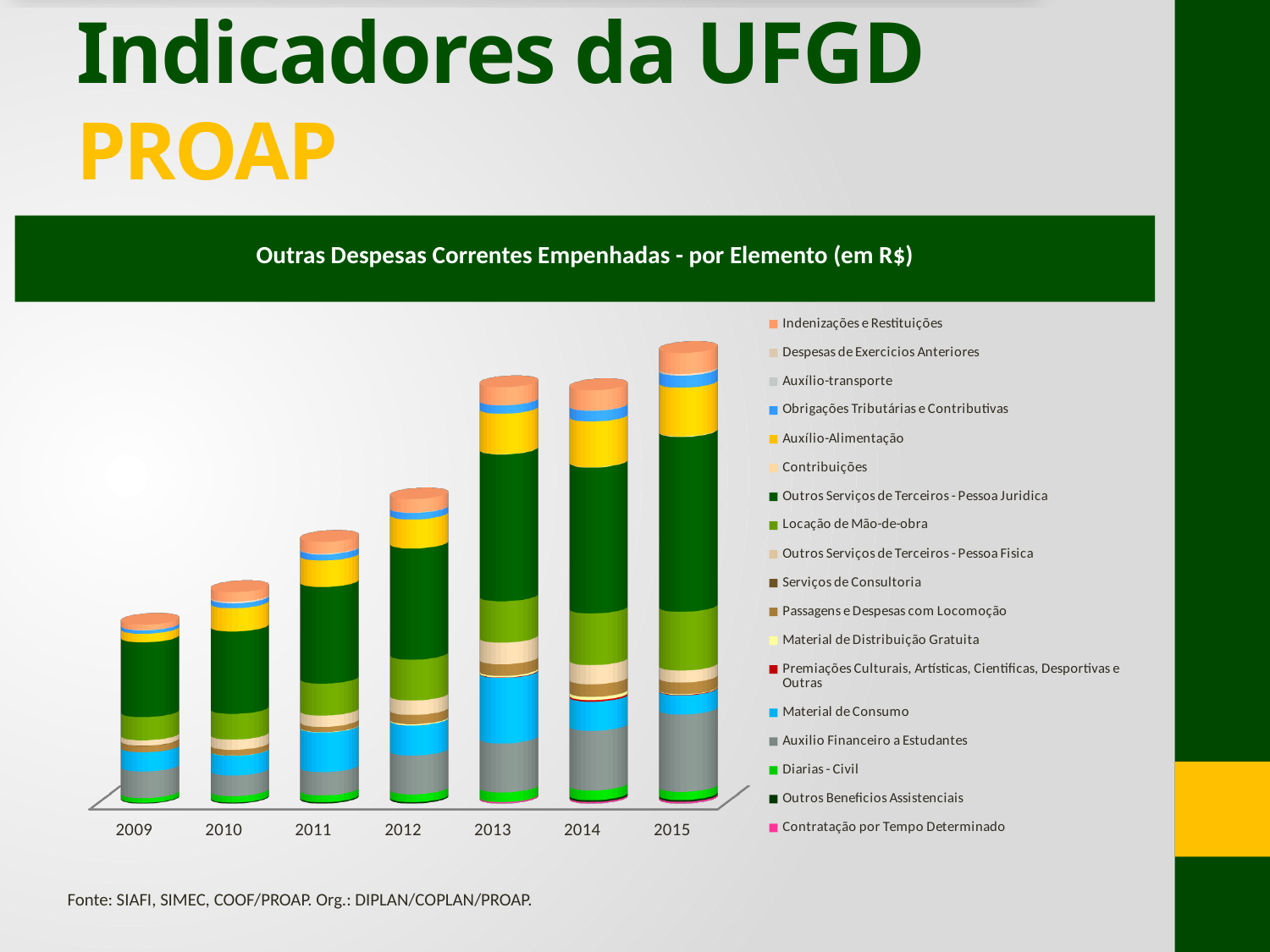
How many series does the chart's legend list? 18 Which series forms the largest segment of the 2015 bar? Outros Serviços de Terceiros - Pessoa Juridica Which year has a taller stacked bar, 2010 or 2011? 2011 Which year has the shortest stacked bar (lowest total)? 2009 What is the title of the chart? Outras Despesas Correntes Empenhadas - por Elemento (em R$) Do the total bar heights generally rise or fall from 2009 to 2015? Rise Which legend entry is listed last (at the bottom of the legend)? Contratação por Tempo Determinado Which year has a taller stacked bar, 2012 or 2013? 2013 What is the first year shown on the x axis? 2009 How many years are shown along the x axis of the chart? 7 Which year has the tallest stacked bar (highest total)? 2015 What kind of chart is shown on the slide? Stacked bar chart